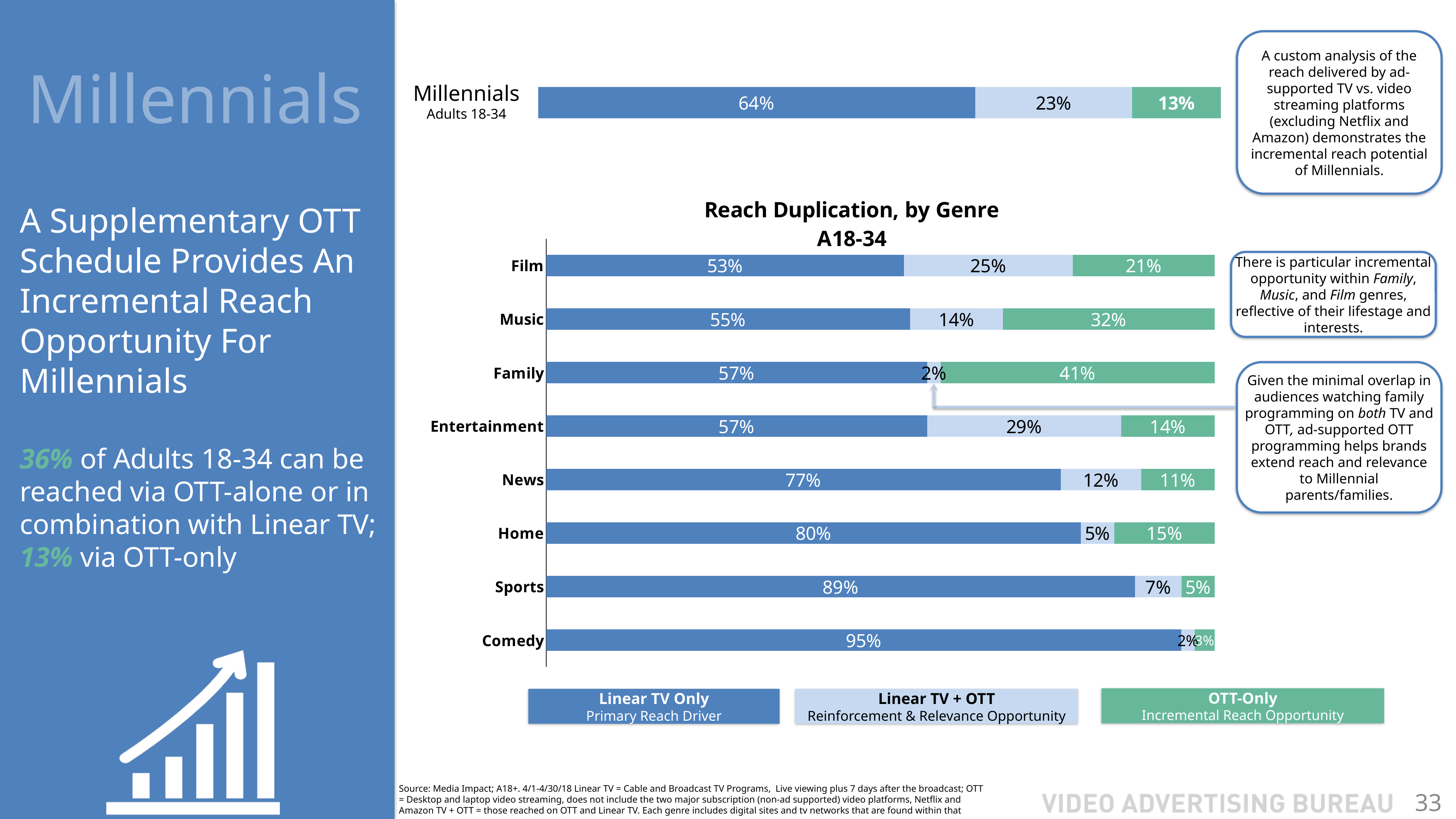
In the top Millennials Adults 18-34 bar, what is the Linear TV + OTT value? 23% How many series does the legend below the Reach Duplication, by Genre chart list? 3 In the Reach Duplication, by Genre chart, what is the OTT-Only value for Music? 32% What type of chart is the Reach Duplication, by Genre chart? Stacked bar chart In the Reach Duplication, by Genre chart, which is larger: the Linear TV + OTT value for Film or for Music? Film How many genres are shown in the Reach Duplication, by Genre chart? 8 In the Reach Duplication, by Genre chart, which genre has the lowest Linear TV Only value? Film In the Reach Duplication, by Genre chart, which genre has the highest OTT-Only value? Family In the Reach Duplication, by Genre chart, what is the Linear TV Only value for News? 77% In the Reach Duplication, by Genre chart, what is the Linear TV + OTT value for Entertainment? 29% In the Reach Duplication, by Genre chart, which colour represents OTT-Only? Green In the Reach Duplication, by Genre chart, what is the difference between the Linear TV Only values for Sports and Home? 9%